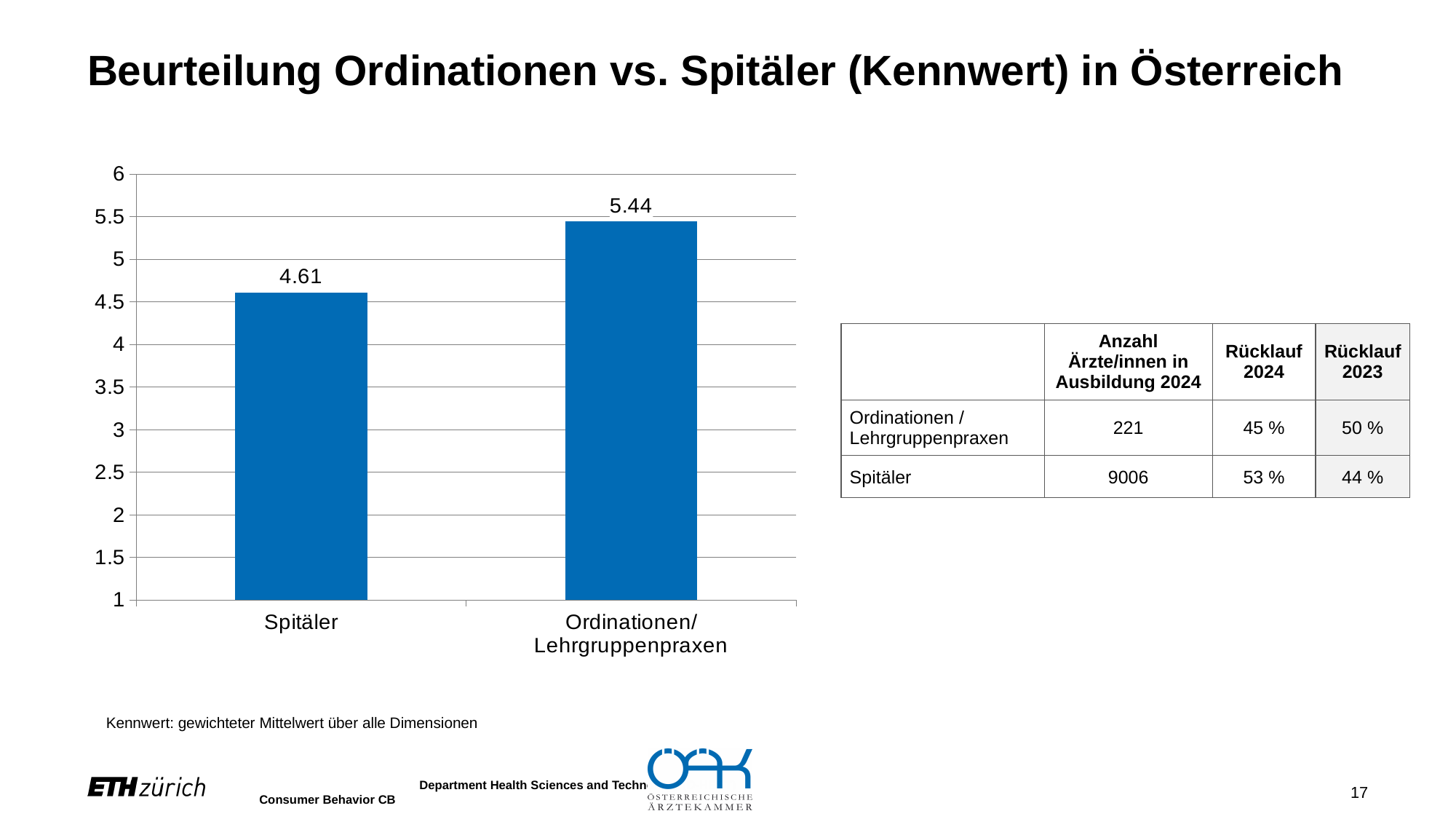
What is the maximum value shown on the y axis of the chart? 6 Which category has the lower Kennwert? Spitäler How many categories are shown in the chart? 2 What colour are the bars in the chart? blue Which category has the higher Kennwert? Ordinationen/Lehrgruppenpraxen Is the Kennwert for Spitäler larger or smaller than that for Ordinationen/Lehrgruppenpraxen? smaller What is the Kennwert value for Ordinationen/Lehrgruppenpraxen? 5.44 What kind of chart is shown on the slide? bar chart Is the value for Spitäler greater or less than 5? less What is the difference between the Kennwert for Ordinationen/Lehrgruppenpraxen and Spitäler? 0.83 What is the Kennwert value for Spitäler? 4.61 Is the value for Ordinationen/Lehrgruppenpraxen greater or less than 5? greater